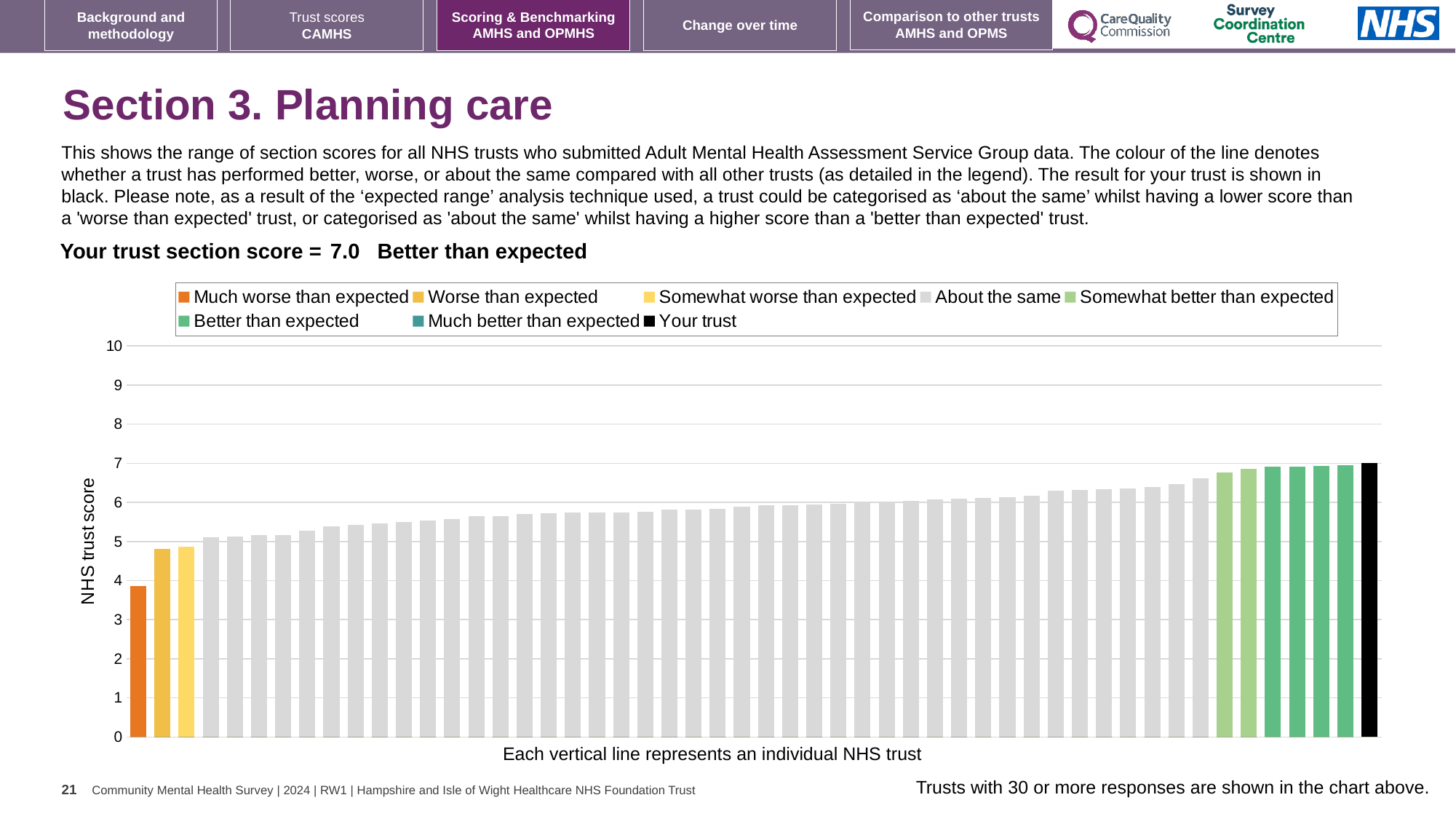
Is the highest bar in the chart greater or less than 8? less What is the label on the vertical axis of the chart? NHS trust score Do the bar values rise or fall from left to right across the chart? rise What is your trust's section score for Planning care? 7.0 Which legend category does the lowest bar in the chart belong to? Much worse than expected What kind of chart is shown on the slide? bar chart How many entries does the chart legend list? 8 Which bar is the tallest in the chart? Your trust Is the value of the lowest (orange) bar greater or less than 5? less How many bars are coloured orange (Much worse than expected)? 1 Is the value of the 'Your trust' bar greater or less than 5? greater Which category does the slide assign to your trust's section score? Better than expected